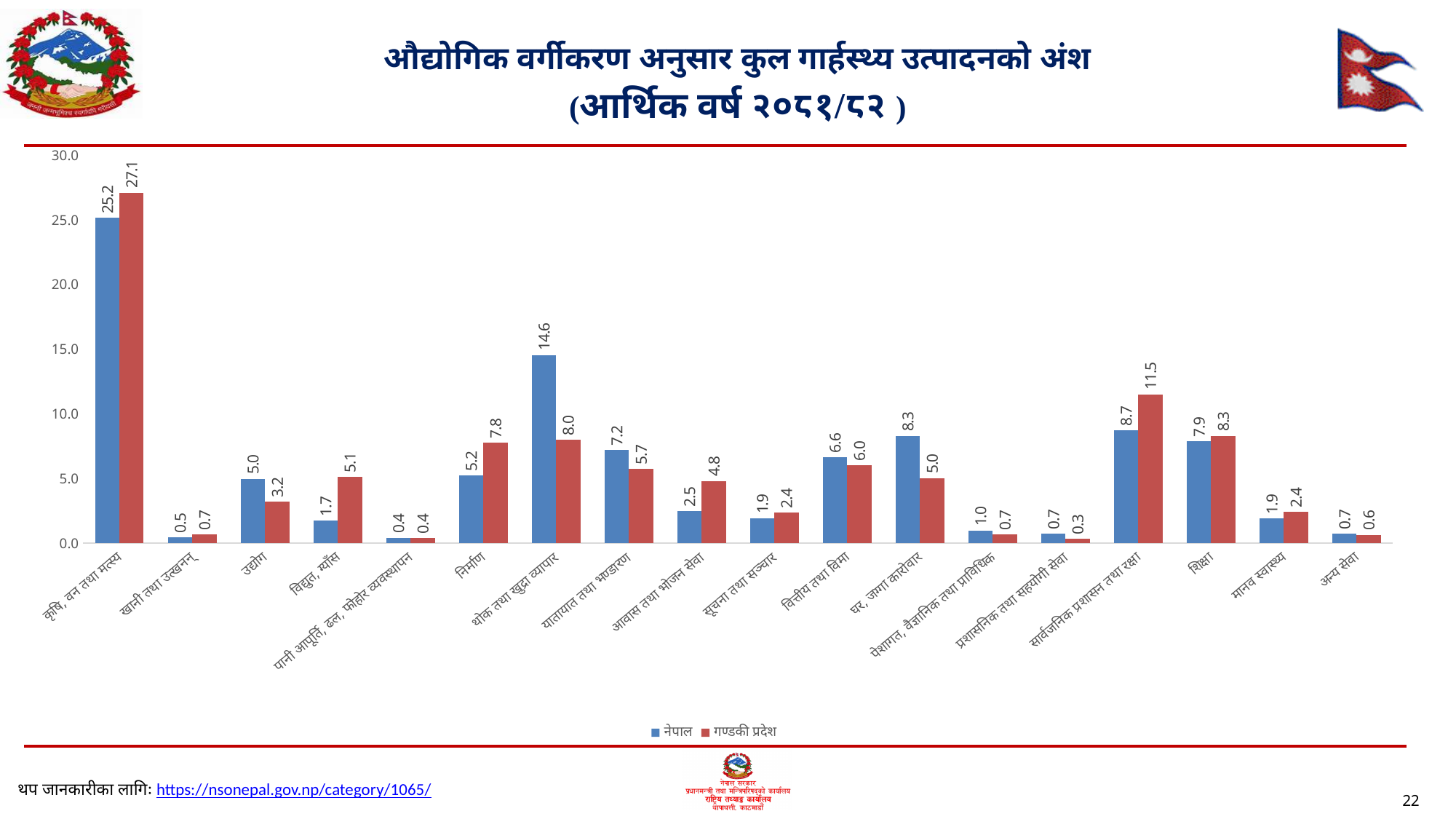
Is the value for नेपाल in the घर, जग्गा कारोबार category greater or less than 10.0? less What is the difference between the नेपाल and गण्डकी प्रदेश values in the थोक तथा खुद्रा व्यापार category? 6.6 What is the value for नेपाल in the थोक तथा खुद्रा व्यापार category? 14.6 Which category has the highest value for नेपाल? कृषि, वन तथा मत्स्य How many series does the legend list? 2 How many categories are shown on the x axis of the chart? 18 In the निर्माण category, which series has the larger value, नेपाल or गण्डकी प्रदेश? गण्डकी प्रदेश What is the value for गण्डकी प्रदेश in the कृषि, वन तथा मत्स्य category? 27.1 What is the value for गण्डकी प्रदेश in the सार्वजनिक प्रशासन तथा रक्षा category? 11.5 Which colour represents the गण्डकी प्रदेश series in the chart? red What kind of chart is shown on the slide? bar chart Which category has the lowest value for गण्डकी प्रदेश? प्रशासनिक तथा सहयोगी सेवा